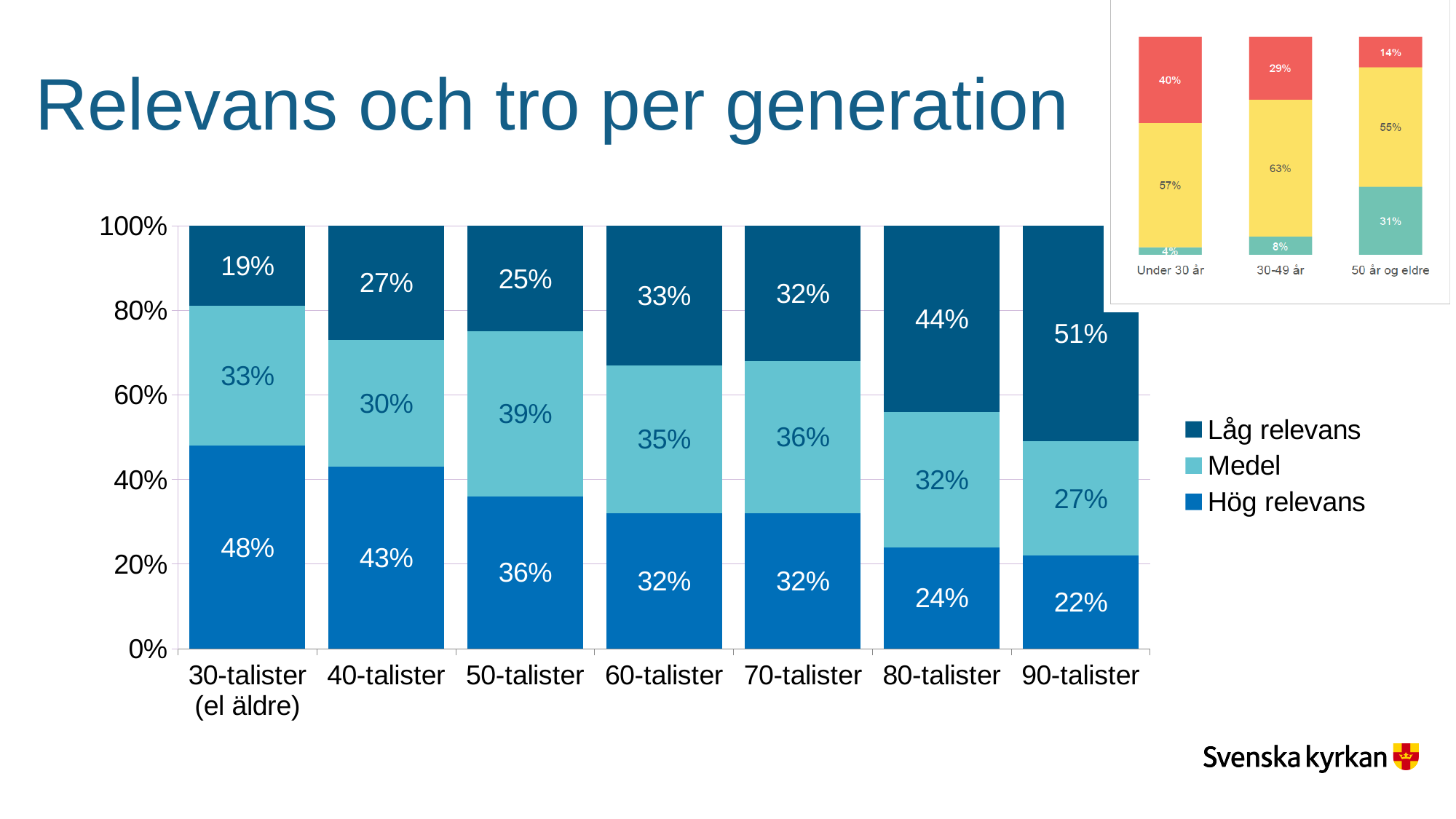
How many series does the legend of the main chart list? 3 In the main chart, what is the Medel value for 50-talister? 39% In the main chart, what is the difference between the Hög relevans values for 30-talister (el äldre) and 90-talister? 26% In the main chart, which is larger: the Låg relevans value for 80-talister or for 60-talister? 80-talister In the main chart, what is the Hög relevans value for 30-talister (el äldre)? 48% In the main chart, which generation has the lowest Hög relevans value? 90-talister In the main chart, which generation has the highest Låg relevans value? 90-talister How many generation categories are shown in the main chart? 7 In the small inset chart in the top right, what is the value of the red segment for Under 30 år? 40% In the main chart, does the Hög relevans value rise or fall from 30-talister (el äldre) to 90-talister? Fall What kind of chart is the main chart on the slide? Stacked bar chart In the main chart, what is the Låg relevans value for 90-talister? 51%